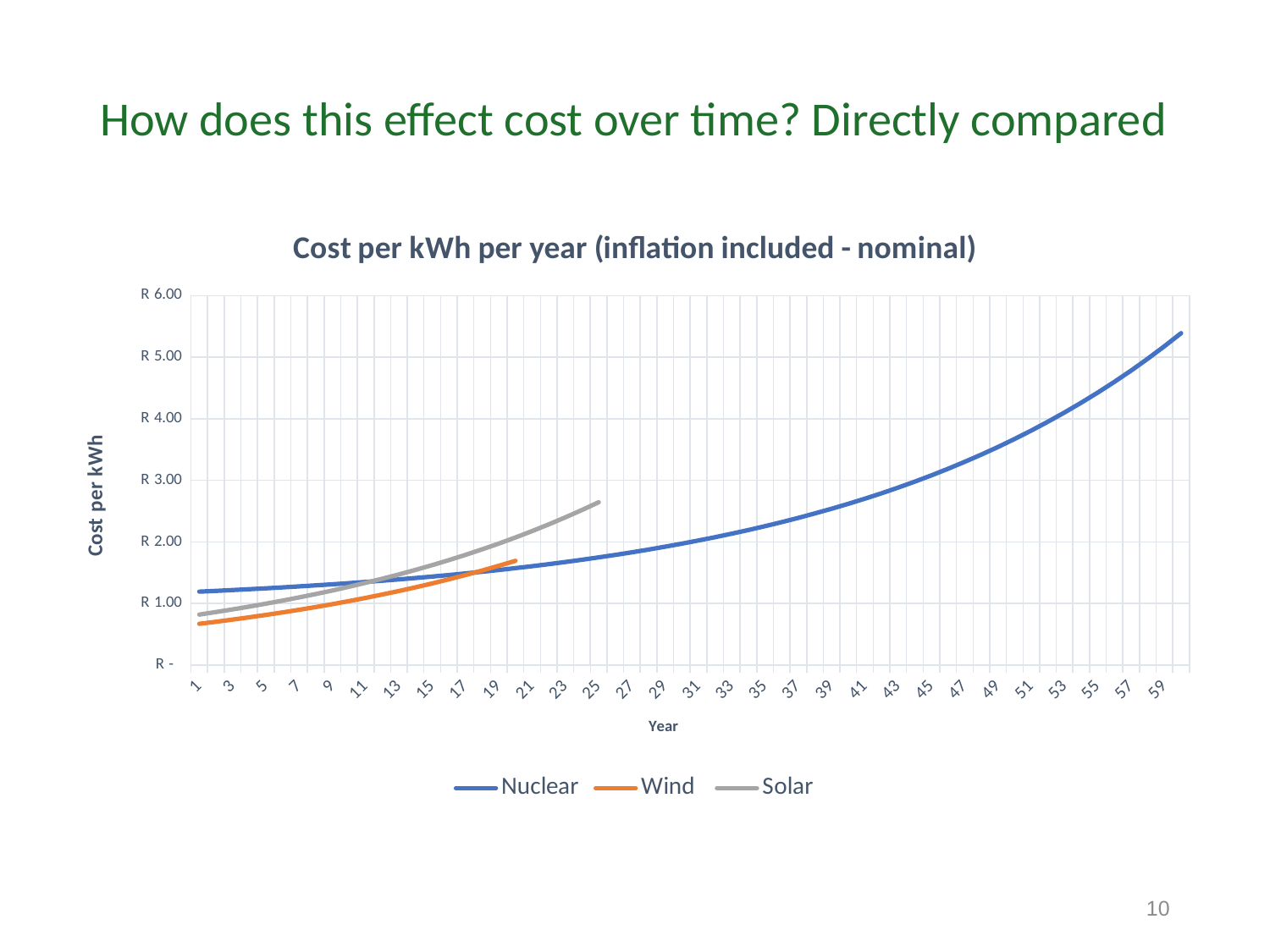
What is the label on the vertical axis? Cost per kWh Is the Wind value at year 1 greater or less than R 1.00? less Is the Nuclear value at year 49 greater or less than R 3.00? greater How many series does the legend list? 3 At year 1, which series has the higher cost, Nuclear or Wind? Nuclear What kind of chart is shown on the slide? Line chart Is the Nuclear value at year 59 greater or less than R 5.00? greater At year 25, which series has the higher cost, Solar or Nuclear? Solar Does the Nuclear cost rise or fall as the years increase? Rise What is the title of the chart? Cost per kWh per year (inflation included - nominal)